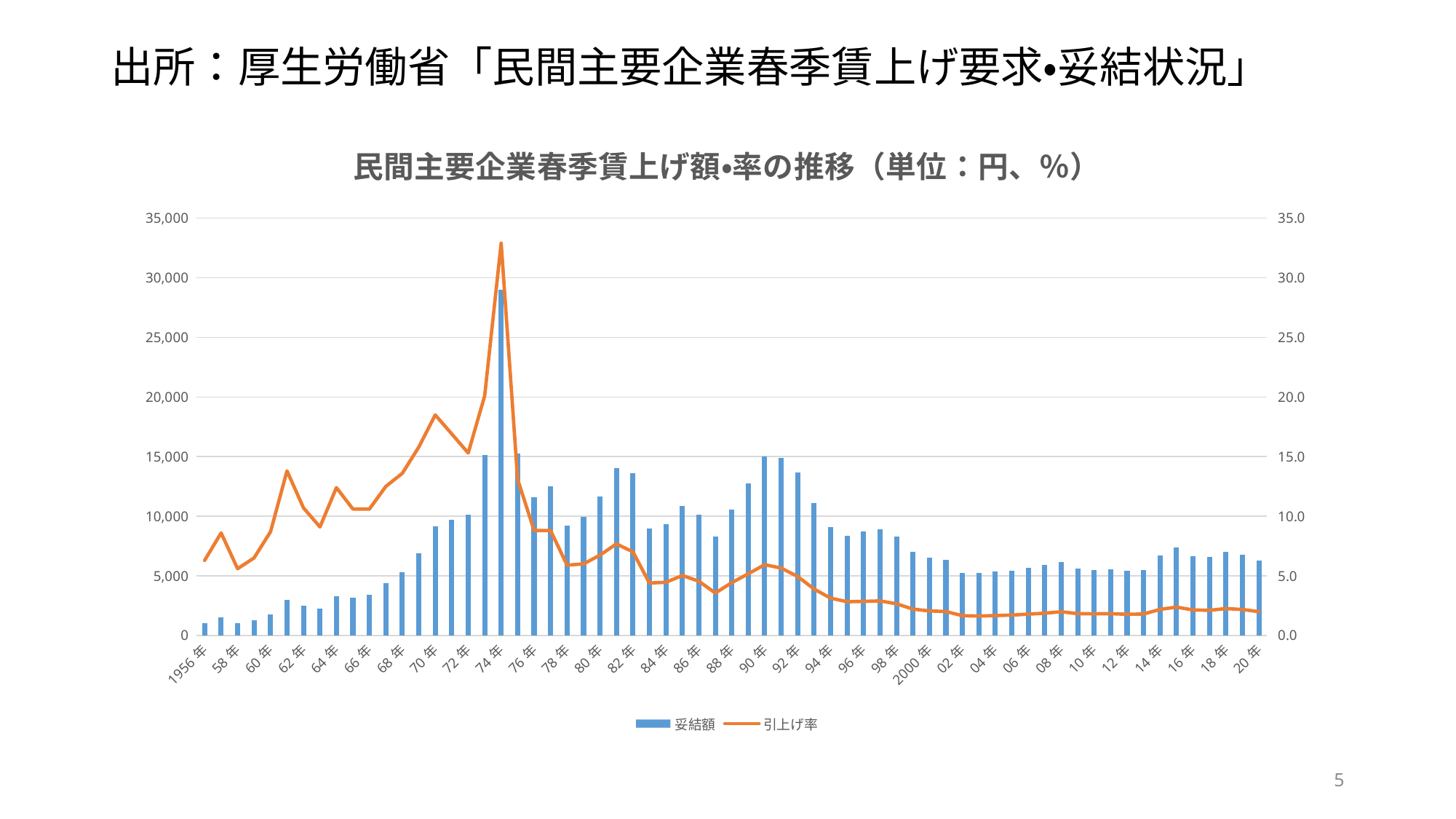
In which year does the 引上げ率 line reach its highest point? 74年 Does the 引上げ率 line generally rise or fall from 74年 to 20年? fall Which series is drawn as bars? 妥結額 Is the 引上げ率 value for 20年 greater or less than 5.0? less Is the 妥結額 value for 74年 greater or less than 25,000? greater How many series does the legend list? 2 What kind of chart is shown on the slide? A combined bar and line chart Is the 妥結額 value for 1956年 greater or less than 5,000? less What is the title of the chart? 民間主要企業春季賃上げ額•率の推移（単位：円、%） Which year has the larger 妥結額 bar, 74年 or 76年? 74年 In which year is the 妥結額 bar highest? 74年